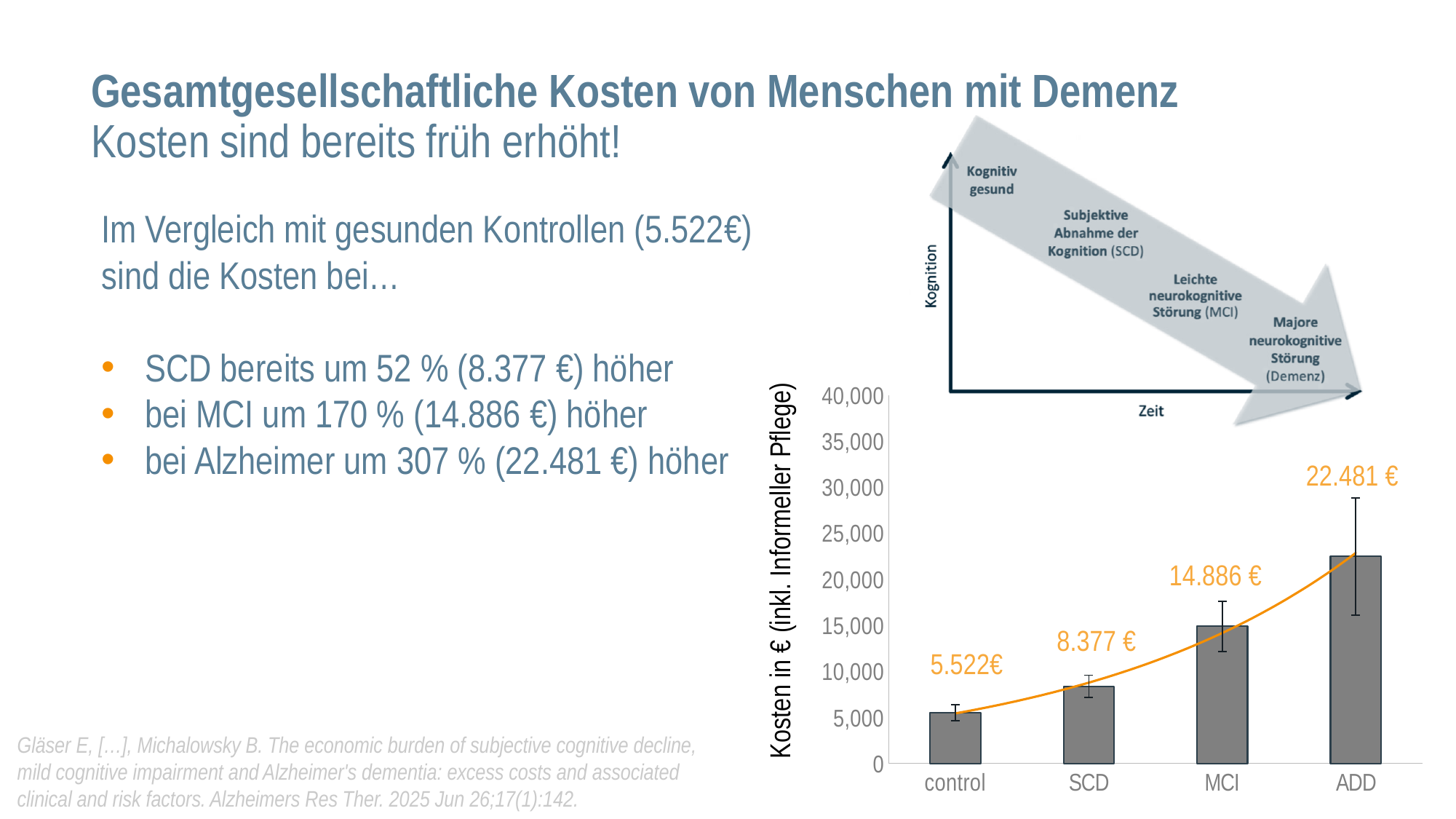
What kind of chart is shown on the slide? bar chart Which is larger in the bar chart, the value for SCD or the value for MCI? MCI What is the difference between the values for MCI and SCD in the bar chart? 6.509 € Do the values rise or fall from control to ADD along the x axis of the bar chart? rise What is the difference between the values for ADD and control in the bar chart? 16.959 € What is the value for ADD in the bar chart? 22.481 € Which category has the highest value in the bar chart? ADD Which category has the lowest value in the bar chart? control Is the value for ADD in the bar chart greater or less than 20,000? greater What is the value for control in the bar chart? 5.522€ What is the value for MCI in the bar chart? 14.886 € How many categories are shown on the x axis of the bar chart? 4